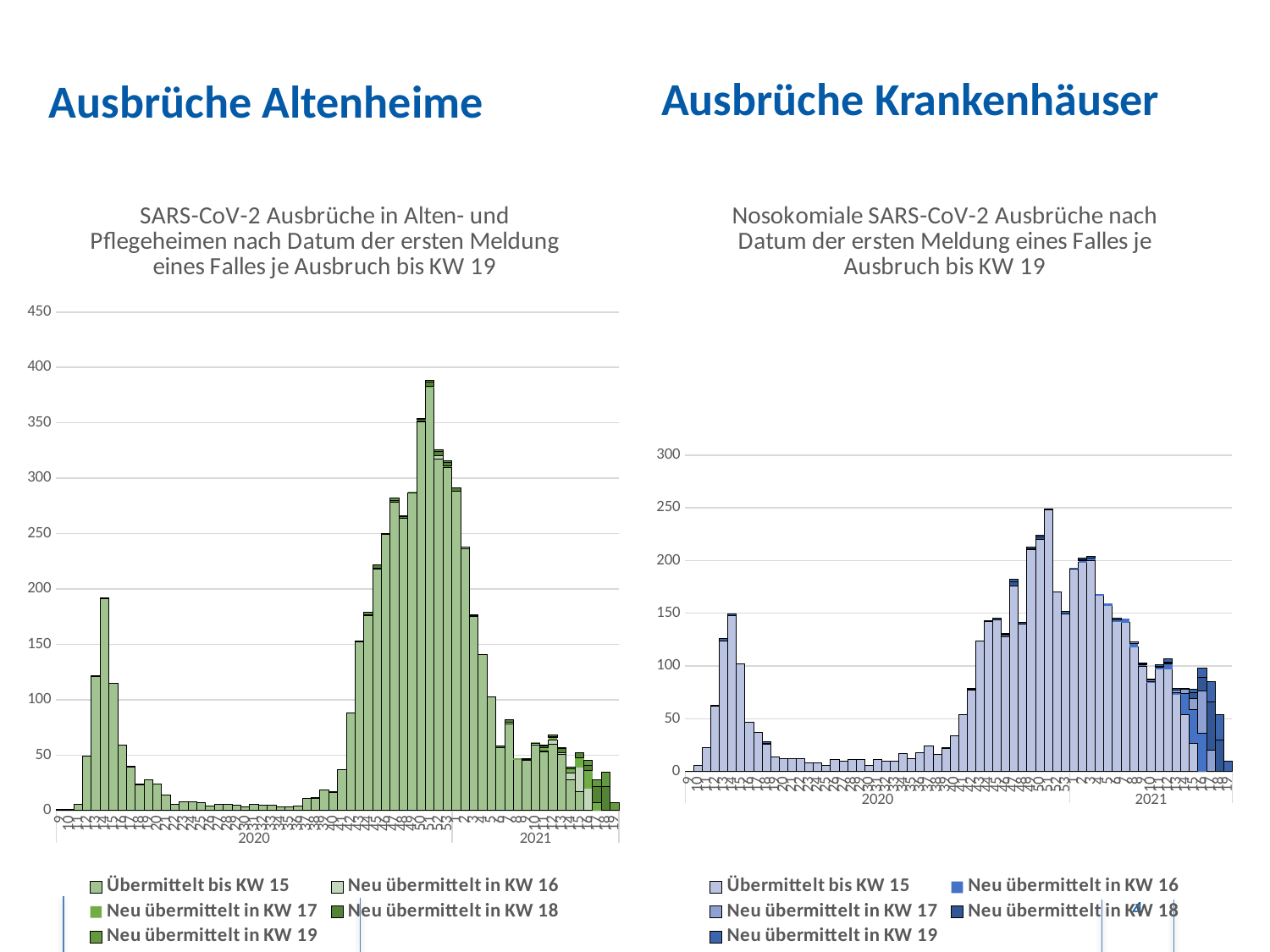
What kind of chart is the right chart, 'Nosokomiale SARS-CoV-2 Ausbrüche'? Stacked bar chart What is the first legend entry of the left chart (Alten- und Pflegeheime)? Übermittelt bis KW 15 In the right chart (Nosokomiale Ausbrüche), is the highest bar greater or less than 200? greater In the left chart (Alten- und Pflegeheime), is the highest bar greater or less than 350? greater How many series does the legend of the right chart (Nosokomiale Ausbrüche) list? 5 What kind of chart is the left chart, 'SARS-CoV-2 Ausbrüche in Alten- und Pflegeheimen'? Stacked bar chart In the left chart (Alten- und Pflegeheime), is the highest bar greater or less than 400? less What is the highest value shown on the y-axis of the right chart (Nosokomiale Ausbrüche)? 300 How many series does the legend of the left chart (Alten- und Pflegeheime) list? 5 Which chart reaches a higher peak value, the left chart (Alten- und Pflegeheime) or the right chart (Nosokomiale Ausbrüche)? The left chart (Alten- und Pflegeheime)